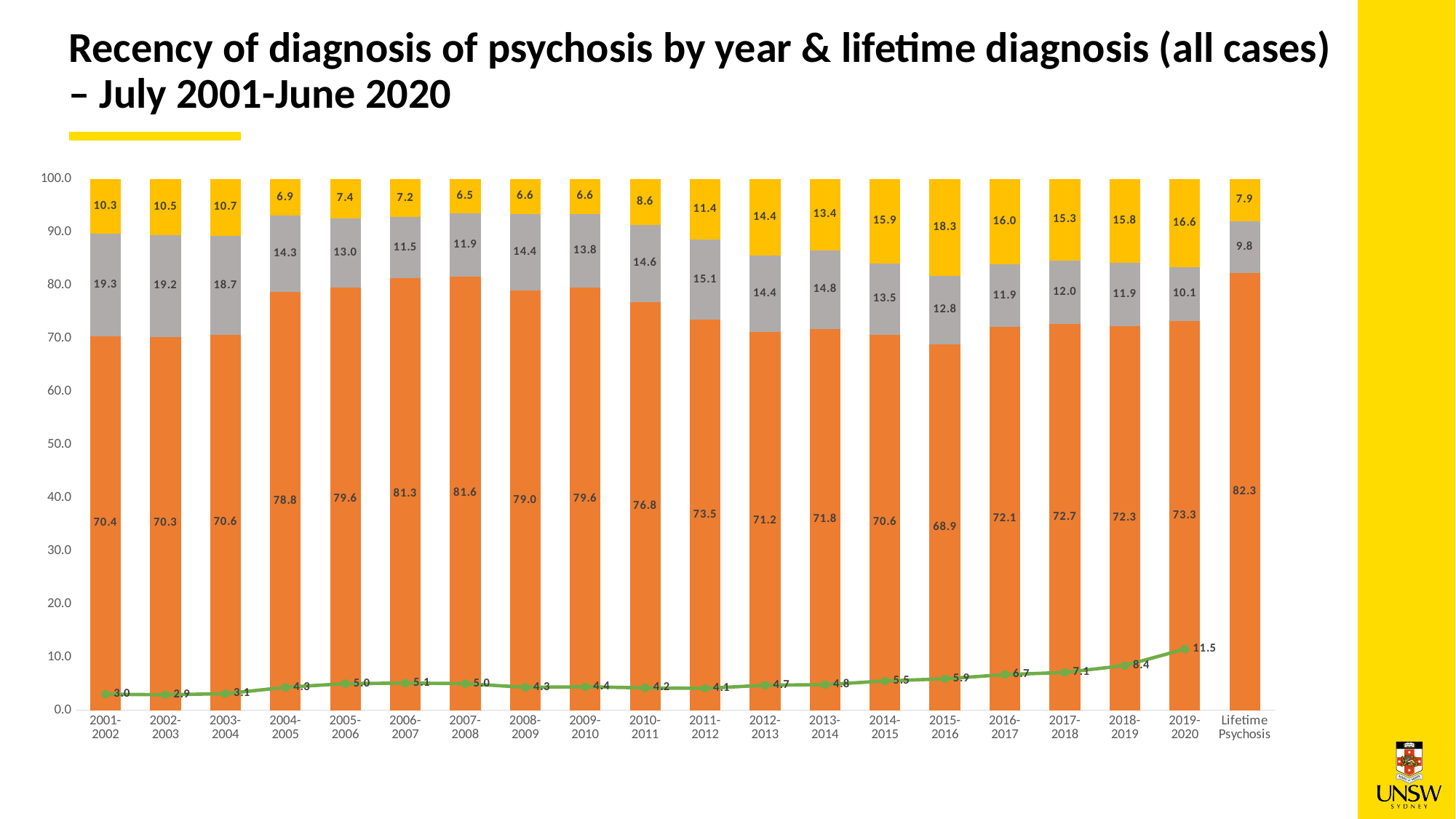
What is the value of the green line at 2019-2020? 11.5 Does the green line generally rise or fall from 2001-2002 to 2019-2020? rise Which category has the highest orange segment value? Lifetime Psychosis What is the value of the orange segment for 2007-2008? 81.6 Is the orange segment for 2006-2007 greater or less than 80.0? greater What is the difference between the yellow segment values for 2015-2016 and 2001-2002? 8.0 Which category has the lowest orange segment value? 2015-2016 Which is larger, the grey segment for 2001-2002 or the grey segment for 2019-2020? 2001-2002 How many categories are shown on the x axis? 20 What is the value of the grey segment for 2011-2012? 15.1 Which category has the highest yellow segment value? 2015-2016 What is the value of the yellow segment for Lifetime Psychosis? 7.9